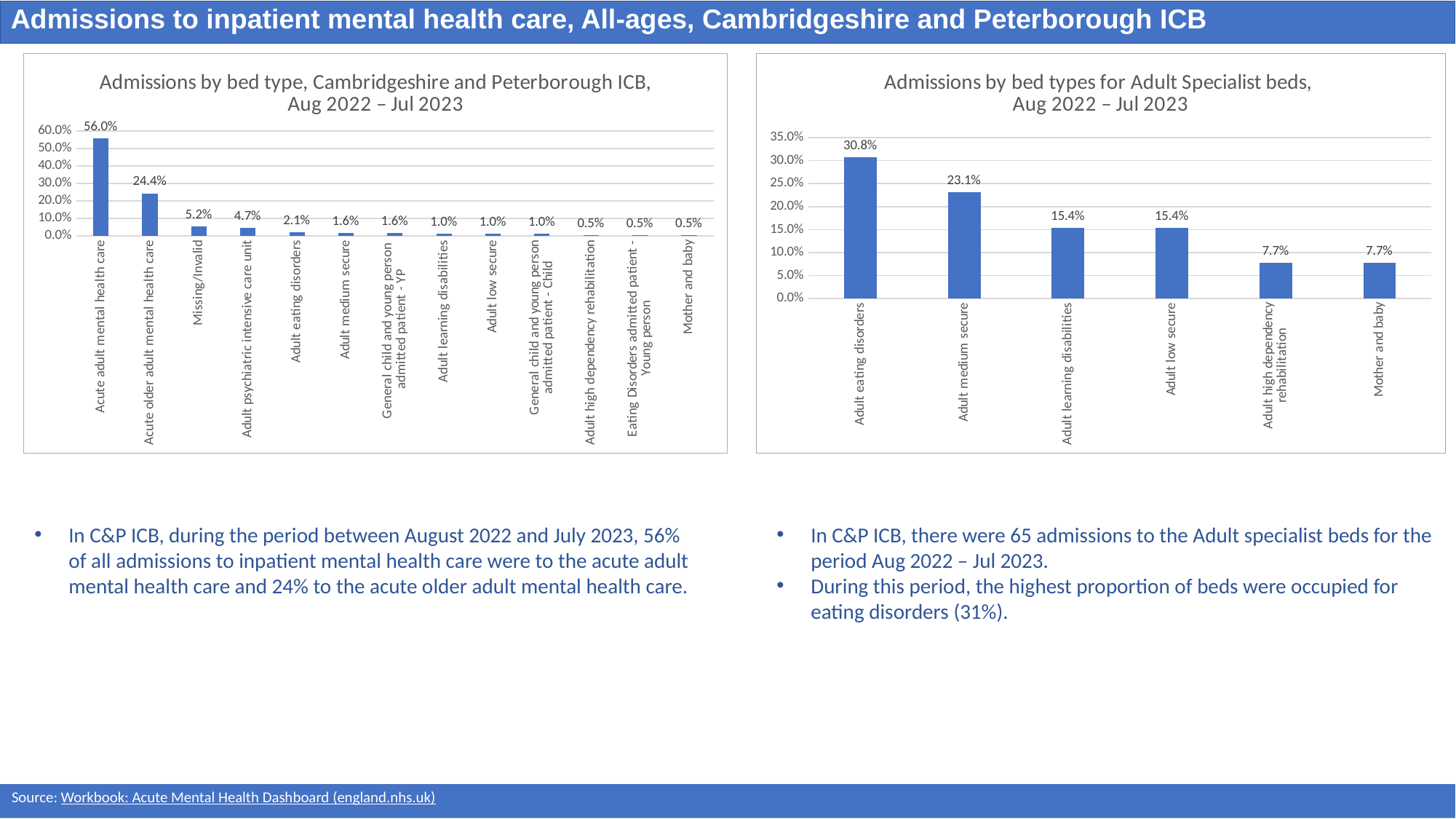
In the right chart (Adult Specialist beds), what is the value for Mother and baby? 7.7% What type of chart is the right chart (Adult Specialist beds)? Bar chart In the left chart (Admissions by bed type), what is the difference between Acute adult mental health care and Acute older adult mental health care? 31.6 percentage points In the right chart (Adult Specialist beds), what is the difference between Adult eating disorders and Adult learning disabilities? 15.4 percentage points In the left chart (Admissions by bed type), which is larger: Adult psychiatric intensive care unit or Adult eating disorders? Adult psychiatric intensive care unit In the left chart (Admissions by bed type), how many bed type categories are shown? 13 In the right chart (Adult Specialist beds), how many bed type categories are shown? 6 In the left chart (Admissions by bed type), what is the value for Acute adult mental health care? 56.0% In the right chart (Adult Specialist beds), what is the value for Adult medium secure? 23.1% In the left chart (Admissions by bed type), which bed type has the highest value? Acute adult mental health care In the left chart (Admissions by bed type), what is the value for Missing/Invalid? 5.2% In the right chart (Adult Specialist beds), which bed type has the highest value? Adult eating disorders